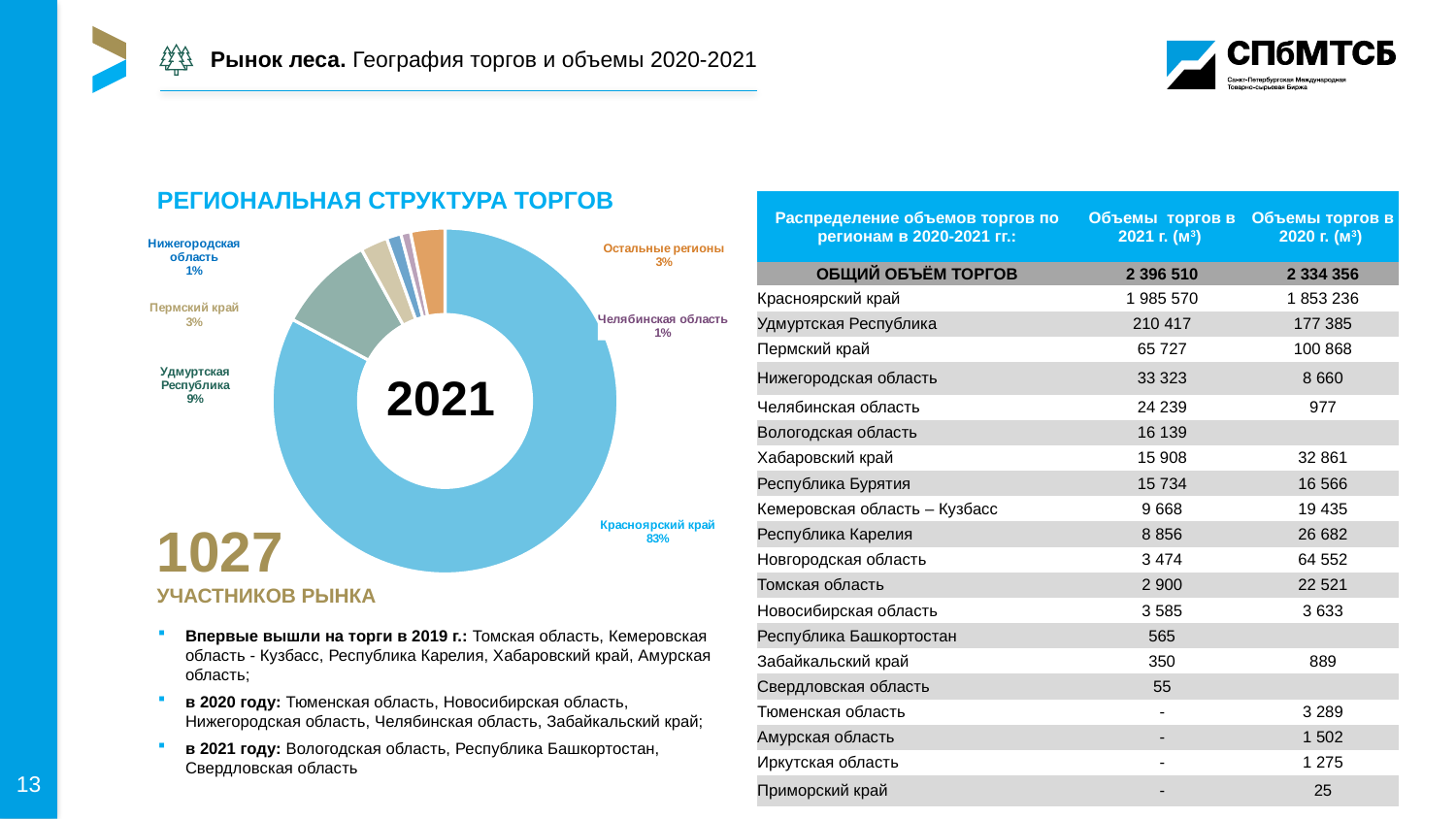
In the pie chart, what share is labelled for Остальные регионы? 3% In the pie chart, which is larger: the share of Удмуртская Республика or the share of Пермский край? Удмуртская Республика In the pie chart, what share does Пермский край have? 3% How many labelled slices does the pie chart have? 6 What type of chart is shown under the heading "РЕГИОНАЛЬНАЯ СТРУКТУРА ТОРГОВ"? Pie (donut) chart In the pie chart, what is the difference in percentage points between the share of Красноярский край and the share of Удмуртская Республика? 74 percentage points In the pie chart, what share does Удмуртская Республика have? 9% In the pie chart, what share does Челябинская область have? 1% Which region has the largest slice in the pie chart? Красноярский край In the pie chart, what share does Красноярский край have? 83% What year is written in the centre of the donut chart? 2021 In the pie chart, what share does Нижегородская область have? 1%